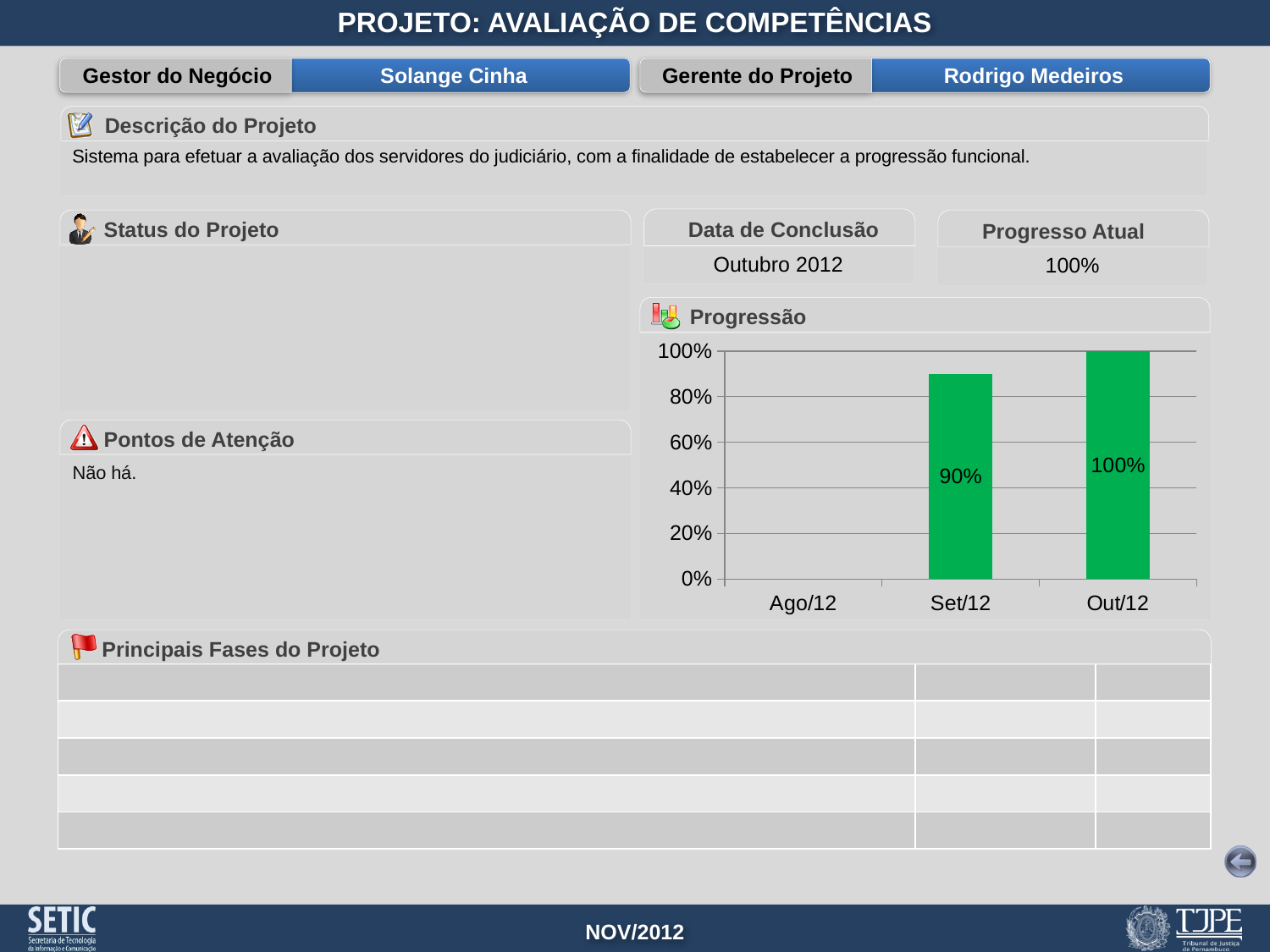
What kind of chart is the Progressão chart? bar chart Which category has the highest value in the Progressão chart? Out/12 What is the title of the chart on the slide? Progressão Do the values in the Progressão chart rise or fall from Set/12 to Out/12? rise What is the highest value shown on the y axis of the Progressão chart? 100% How many categories are shown on the x axis of the Progressão chart? 3 What colour are the bars in the Progressão chart? green Which is larger in the Progressão chart, the value for Set/12 or Out/12? Out/12 What is the value for Set/12 in the Progressão chart? 90% What is the value for Out/12 in the Progressão chart? 100% What is the difference between the values for Out/12 and Set/12 in the Progressão chart? 10% Is the value for Set/12 in the Progressão chart greater or less than 80%? greater